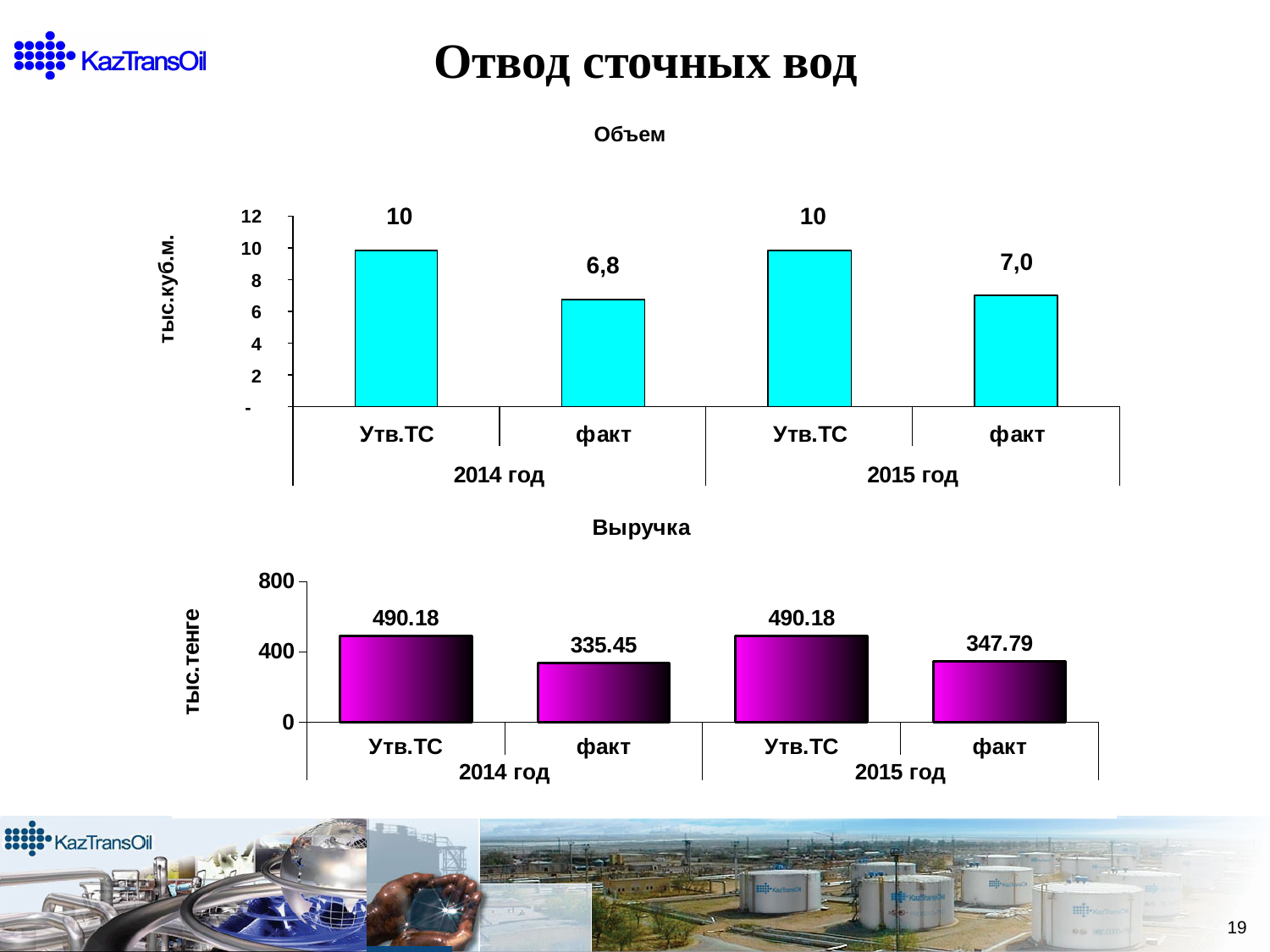
How many bars are plotted in the 'Выручка' chart? 4 In the 'Выручка' chart, what is the difference between Утв.ТС and факт in 2015 год? 142.39 In the 'Выручка' chart, what is the value for Утв.ТС in 2014 год? 490.18 In the 'Выручка' chart, what is the value for факт in 2015 год? 347.79 In the 'Объем' chart, which bar is the lowest? факт, 2014 год In the 'Объем' chart, is the value for факт in 2014 год greater or less than 8? less In the 'Объем' chart, what is the value for факт in 2015 год? 7,0 In the 'Выручка' chart, which is larger: факт in 2014 год or факт in 2015 год? факт in 2015 год In the 'Объем' chart, what is the value for факт in 2014 год? 6,8 In the 'Выручка' chart, what is the value for факт in 2014 год? 335.45 In the 'Объем' chart, what is the value for Утв.ТС in 2015 год? 10 What type of chart is the 'Объем' chart? bar chart